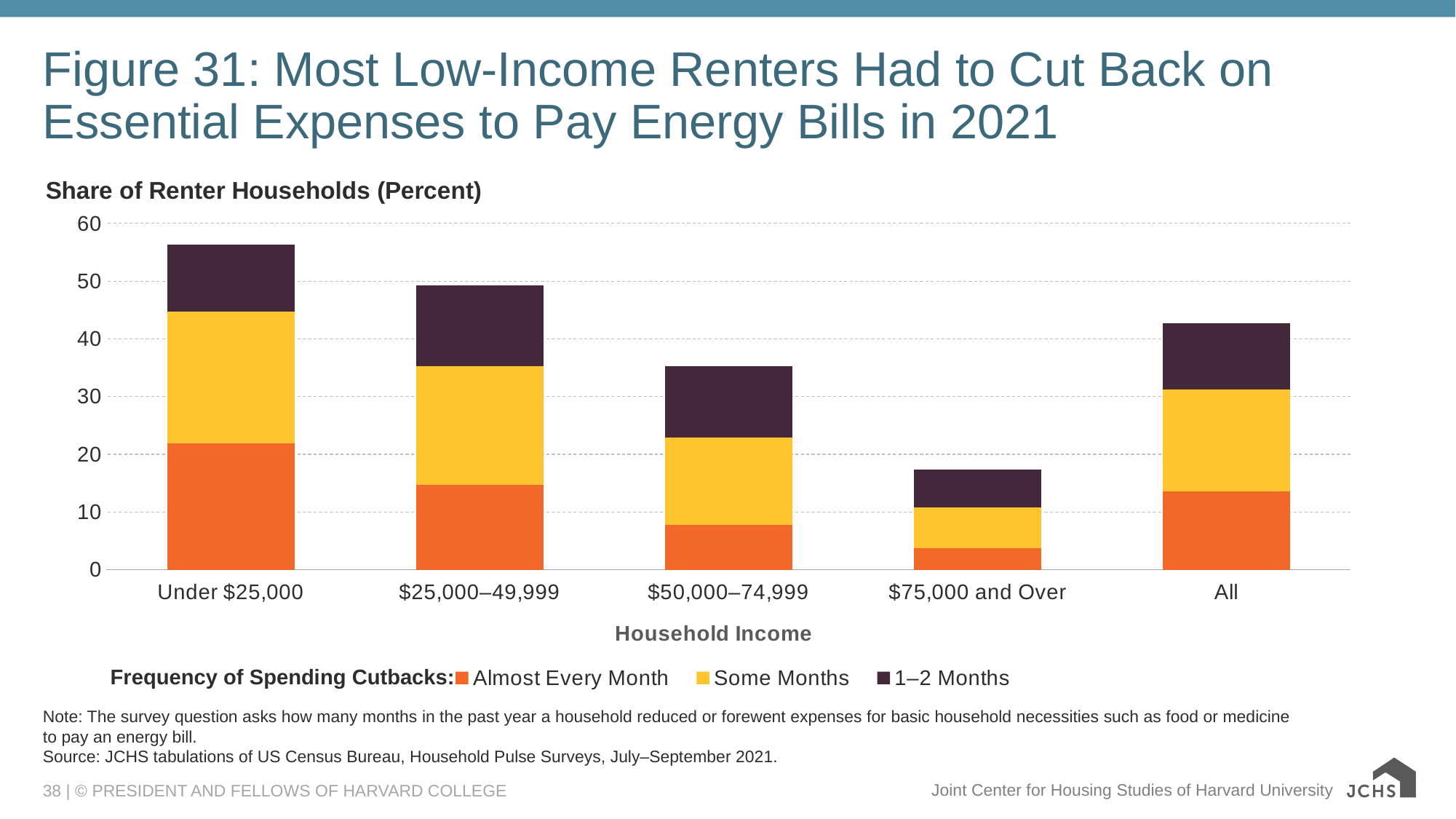
Which household income category has the tallest stacked bar? Under $25,000 Is the total stacked bar for $75,000 and Over greater or less than 20? less Is the total stacked bar for Under $25,000 greater or less than 50? greater Is the total stacked bar for All greater or less than 40? greater Which is larger, the total stacked bar for $25,000–49,999 or for All? $25,000–49,999 How many series does the legend list? 3 Which legend entry is shown in orange? Almost Every Month Moving from Under $25,000 to $75,000 and Over along the x axis, do the total bar heights rise or fall? fall Which household income category has the shortest stacked bar? $75,000 and Over How many household income categories are shown on the x axis? 5 What kind of chart is shown on the slide? stacked bar chart